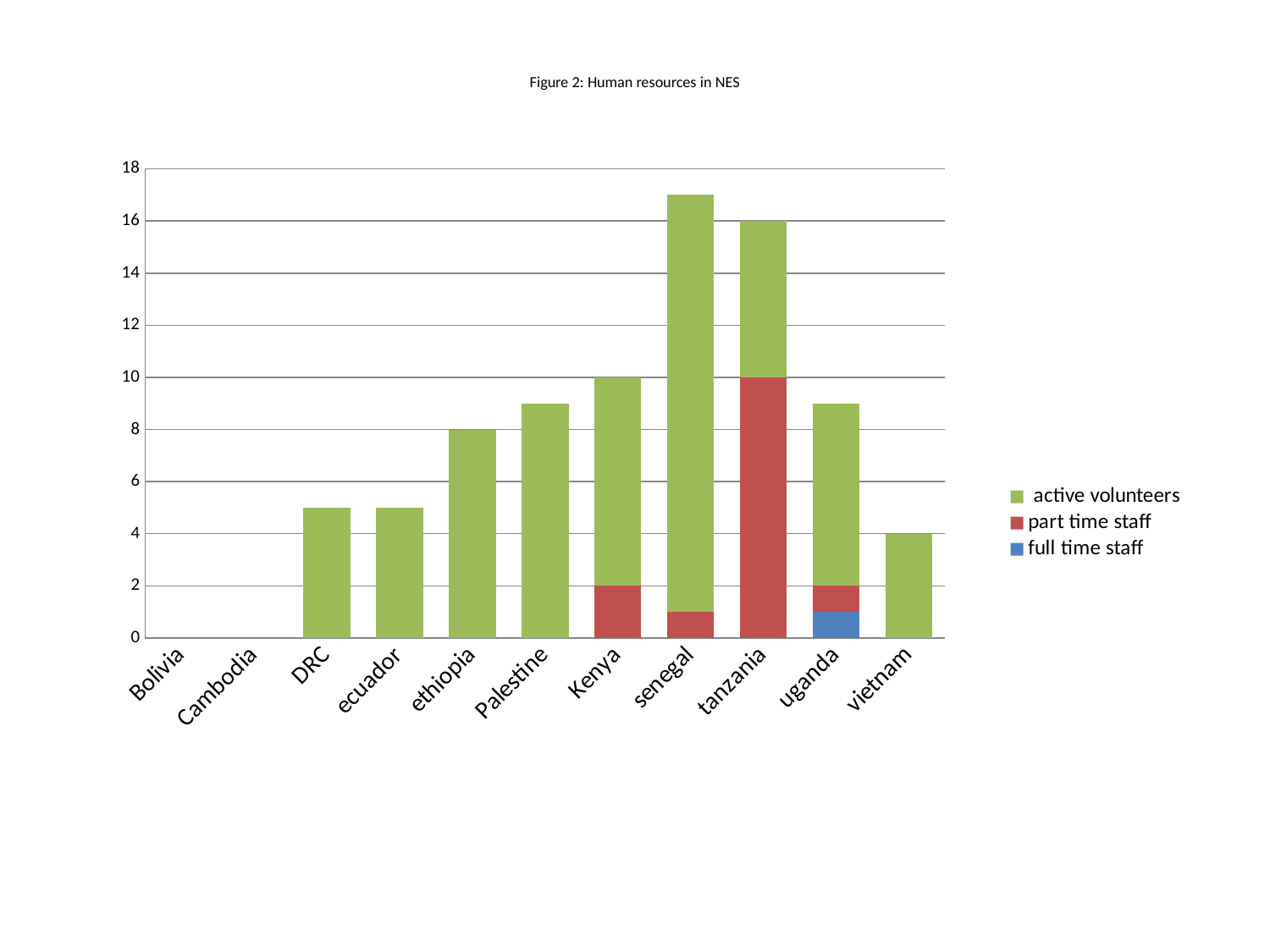
Which country has the tallest bar? senegal What is the total height of the bar for Kenya? 10 Is the total value for Palestine greater or less than 10? less Which has a taller bar, Kenya or ethiopia? Kenya How many series does the legend list? 3 How many part time staff does Kenya have? 2 What kind of chart is shown? stacked bar chart What is the total height of the bar for tanzania? 16 How many part time staff does tanzania have? 10 What is the total height of the bar for ethiopia? 8 How many countries are listed on the x axis? 11 What is the difference between the total bar heights for tanzania and Kenya? 6